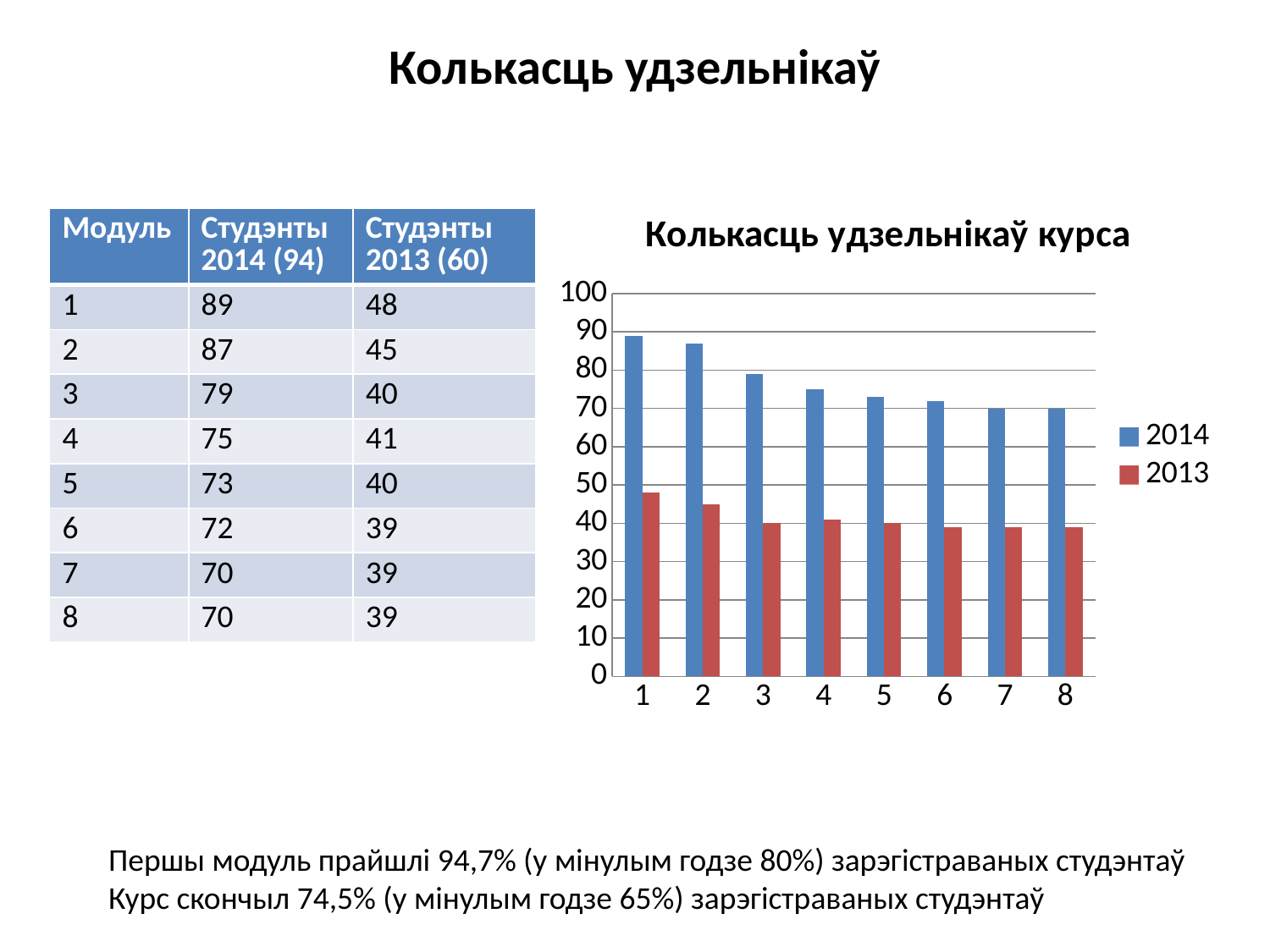
What is the title of the chart? Колькасць удзельнікаў курса Which module has the highest value for the 2014 series? 1 What is the value for 2013 at module 3? 40 How many series does the chart legend list? 2 Which module has the lowest value for the 2013 series? 6, 7 and 8 (39 each) What type of chart is shown on the slide? bar chart What is the difference between the 2014 and 2013 values at module 1? 41 Do the 2014 values rise or fall from module 1 to module 8? fall Is the value for 2013 at module 1 greater or less than 40? greater How many modules (categories) are shown on the x axis of the chart? 8 What is the value for 2014 at module 1? 89 Which is larger at module 4: the 2014 value or the 2013 value? 2014